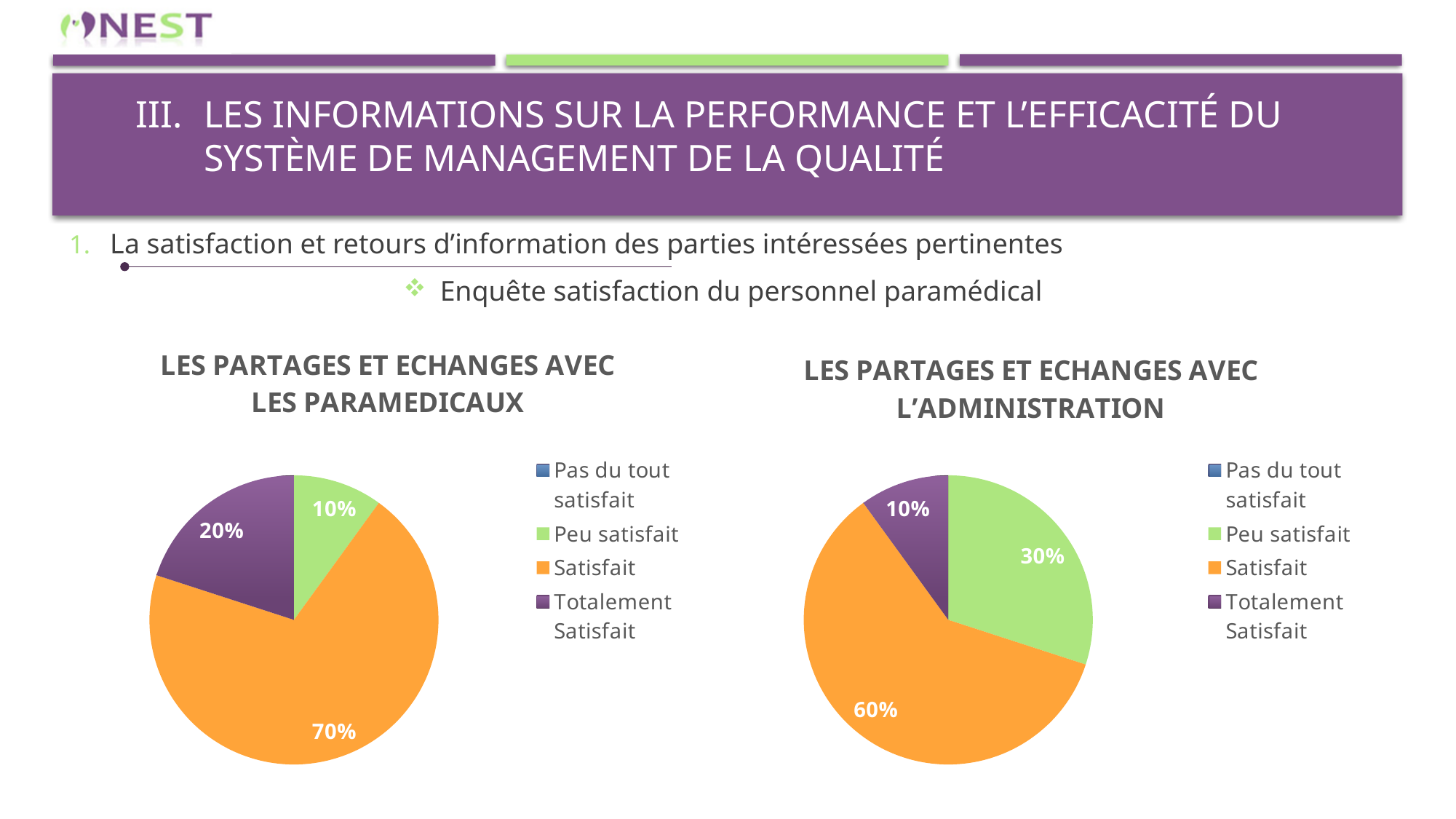
In the chart titled "LES PARTAGES ET ECHANGES AVEC L'ADMINISTRATION", what share is labelled for Satisfait? 60% In the chart titled "LES PARTAGES ET ECHANGES AVEC LES PARAMEDICAUX", what share is labelled for Totalement Satisfait? 20% In the chart titled "LES PARTAGES ET ECHANGES AVEC LES PARAMEDICAUX", what is the difference between the Satisfait and Totalement Satisfait shares? 50% In the chart titled "LES PARTAGES ET ECHANGES AVEC L'ADMINISTRATION", what share is labelled for Totalement Satisfait? 10% In the chart titled "LES PARTAGES ET ECHANGES AVEC LES PARAMEDICAUX", which category has the largest slice? Satisfait In the chart titled "LES PARTAGES ET ECHANGES AVEC LES PARAMEDICAUX", what share is labelled for Satisfait? 70% Which chart shows a larger share for Peu satisfait, the one for LES PARAMEDICAUX or the one for L'ADMINISTRATION? L'ADMINISTRATION How many entries does the legend of the chart titled "LES PARTAGES ET ECHANGES AVEC L'ADMINISTRATION" list? 4 In the chart titled "LES PARTAGES ET ECHANGES AVEC LES PARAMEDICAUX", what share is labelled for Peu satisfait? 10% In the chart titled "LES PARTAGES ET ECHANGES AVEC L'ADMINISTRATION", what share is labelled for Peu satisfait? 30% In the chart titled "LES PARTAGES ET ECHANGES AVEC L'ADMINISTRATION", which labelled category has the smallest slice? Totalement Satisfait What type of chart is used on the left of the slide, titled "LES PARTAGES ET ECHANGES AVEC LES PARAMEDICAUX"? Pie chart